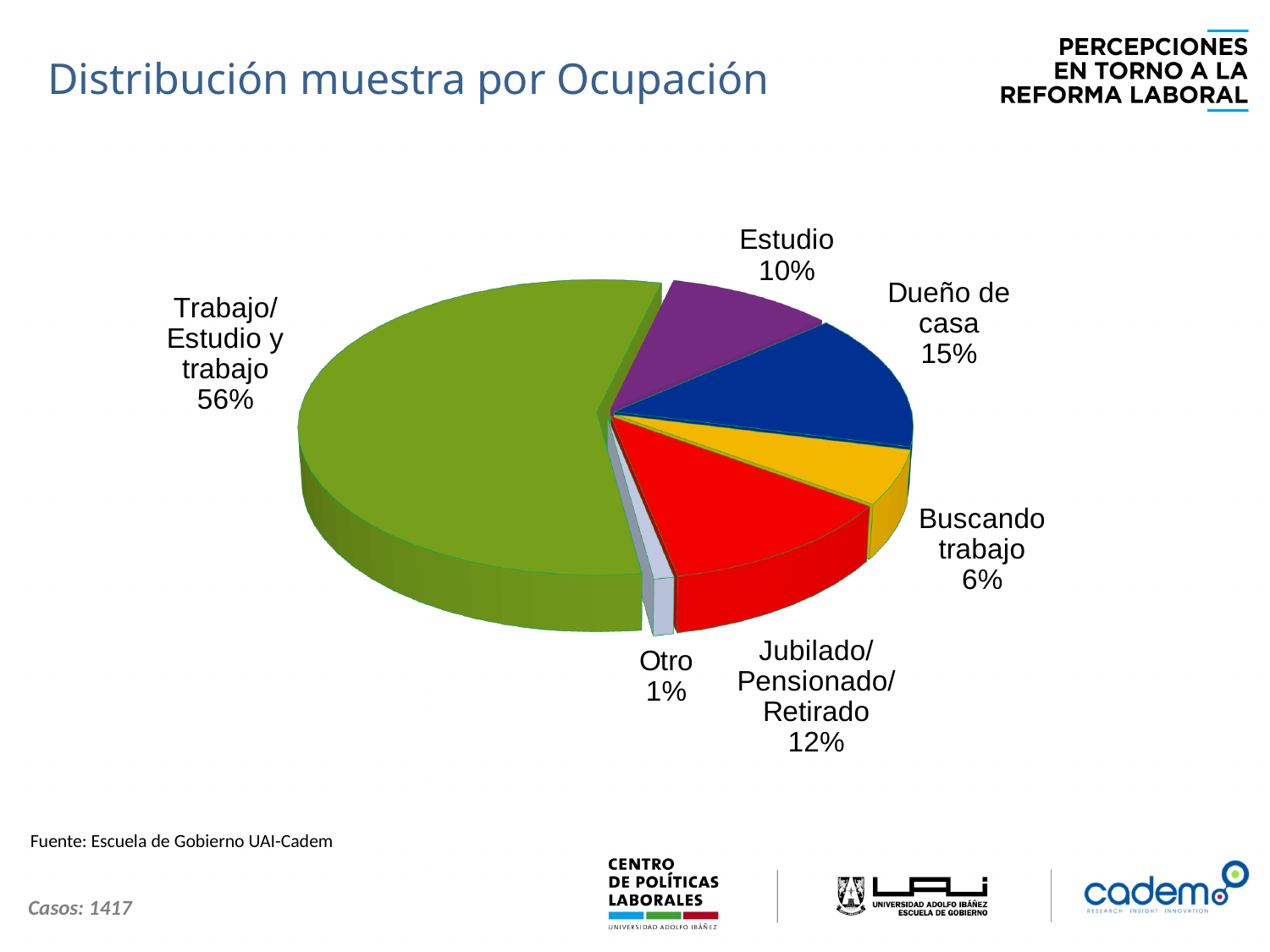
What percentage of the sample is Buscando trabajo? 6% What percentage of the sample is Dueño de casa? 15% What share of the sample is Trabajo/Estudio y trabajo? 56% Which occupation category has the smallest share of the sample? Otro What percentage of the sample is Jubilado/Pensionado/Retirado? 12% What colour is the slice for Trabajo/Estudio y trabajo? Green How many occupation categories are shown in the pie chart? 6 What is the difference in percentage points between Dueño de casa and Estudio? 5 What kind of chart is shown on the slide? Pie chart What is the title of the slide? Distribución muestra por Ocupación Which is larger, the share for Jubilado/Pensionado/Retirado or the share for Estudio? Jubilado/Pensionado/Retirado Which occupation category has the largest share of the sample? Trabajo/Estudio y trabajo